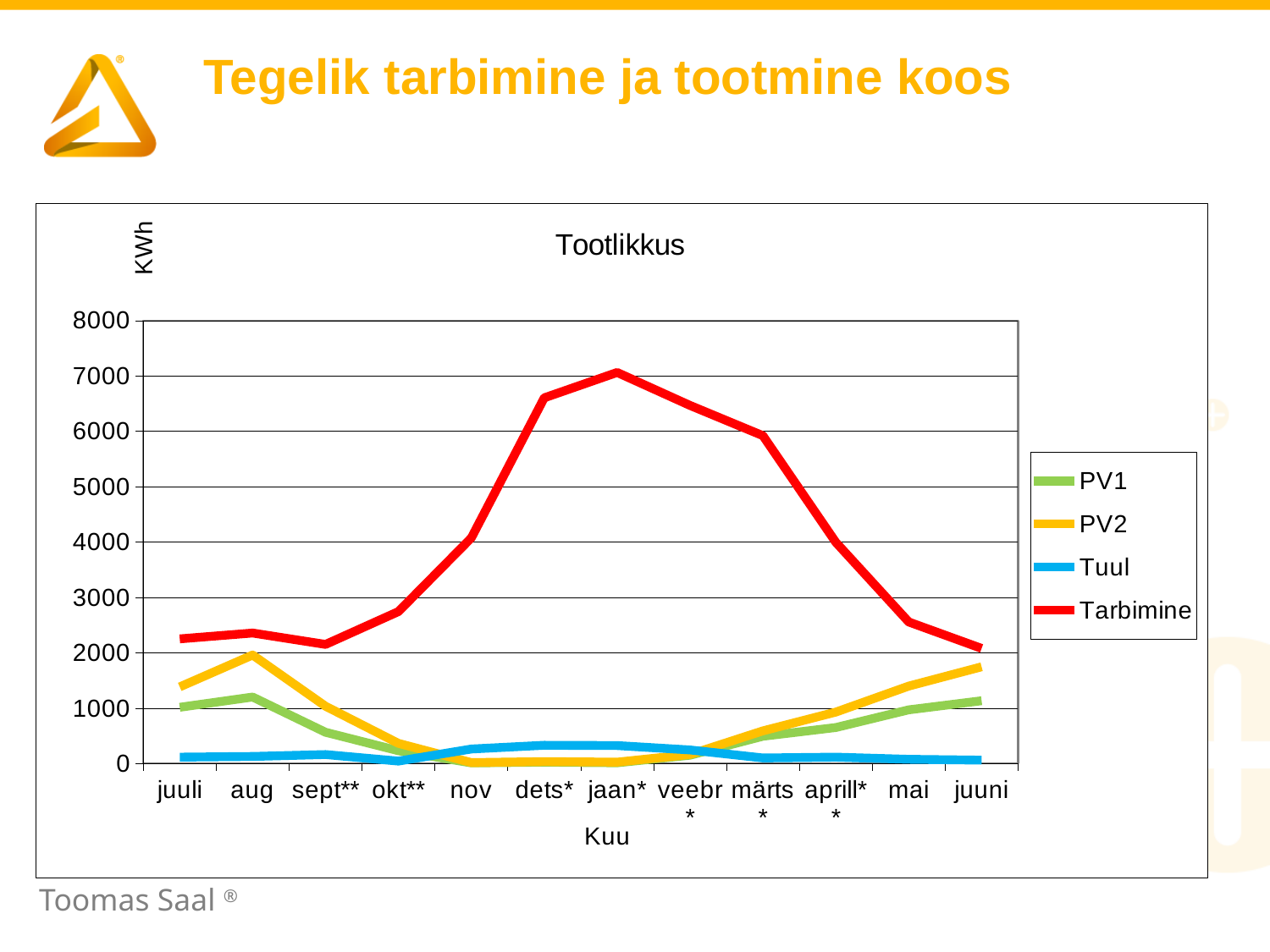
What colour is the Tarbimine line in the legend? red Which series has the larger value in aug, PV1 or PV2? PV2 Is the value of Tarbimine in nov greater or less than 5000? less How many months are shown on the x axis? 12 In which month does the Tarbimine series reach its highest value? jaan* Which series has the larger value in jaan*, Tarbimine or Tuul? Tarbimine What kind of chart is shown on the slide? line chart Is the value of Tarbimine in dets* greater or less than 6000? greater Is the value of PV2 in aug greater or less than 1000? greater How many series does the legend list? 4 Does the Tarbimine series rise or fall from juuli to jaan*? rise What is the title of the chart? Tootlikkus